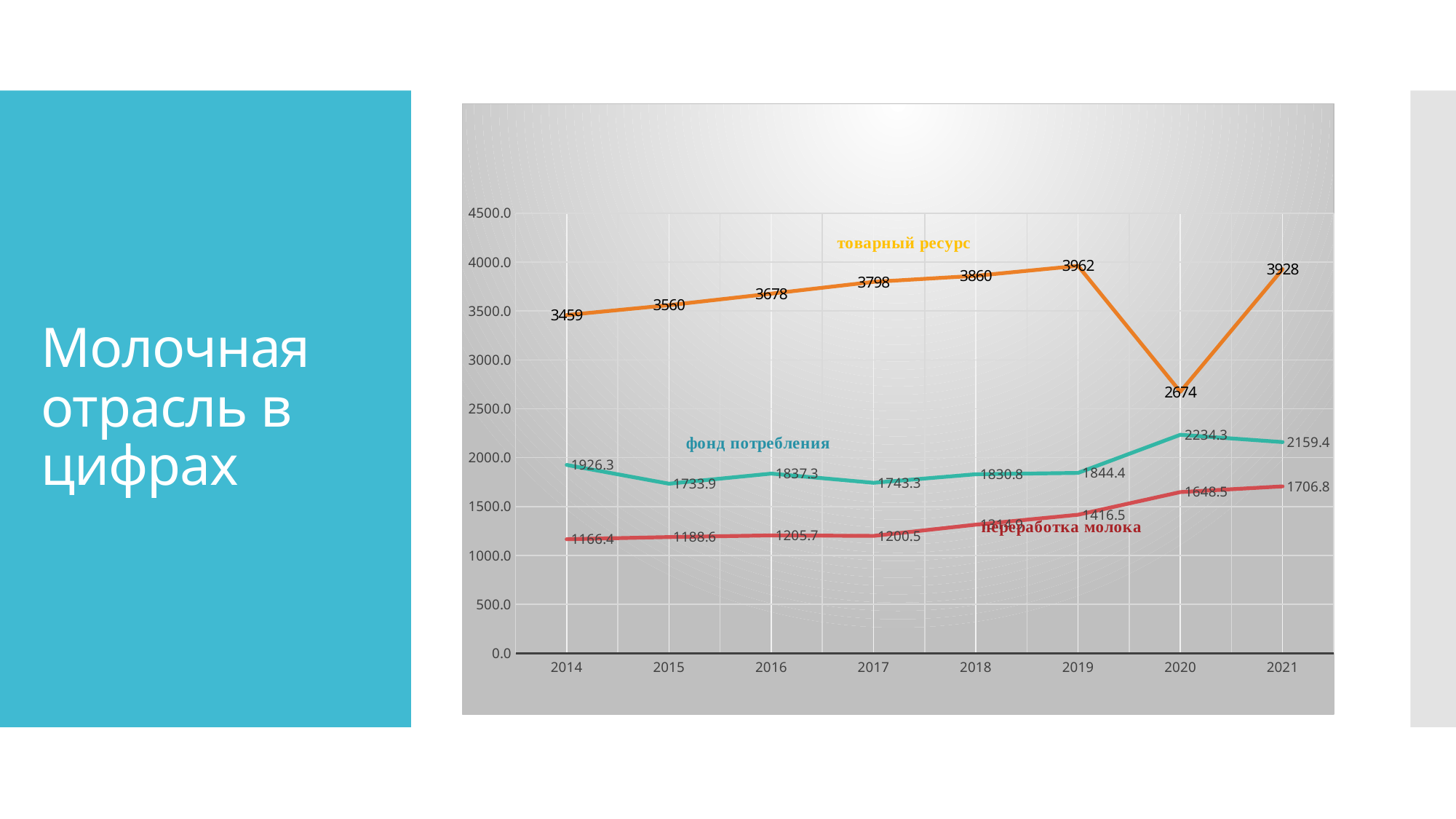
What is the value of фонд потребления in 2020? 2234.3 What colour is the line for товарный ресурс? orange In which year is фонд потребления highest? 2020 What is the difference between товарный ресурс in 2019 and in 2020? 1288 What is the value of переработка молока in 2021? 1706.8 In which year is товарный ресурс lowest? 2020 Which is larger: фонд потребления in 2014 or in 2015? 2014 How many years are shown on the x axis? 8 How many data series (lines) are plotted on the chart? 3 Does переработка молока rise or fall from 2019 to 2021? rise What type of chart is shown on the slide? line chart What is the value of товарный ресурс in 2019? 3962